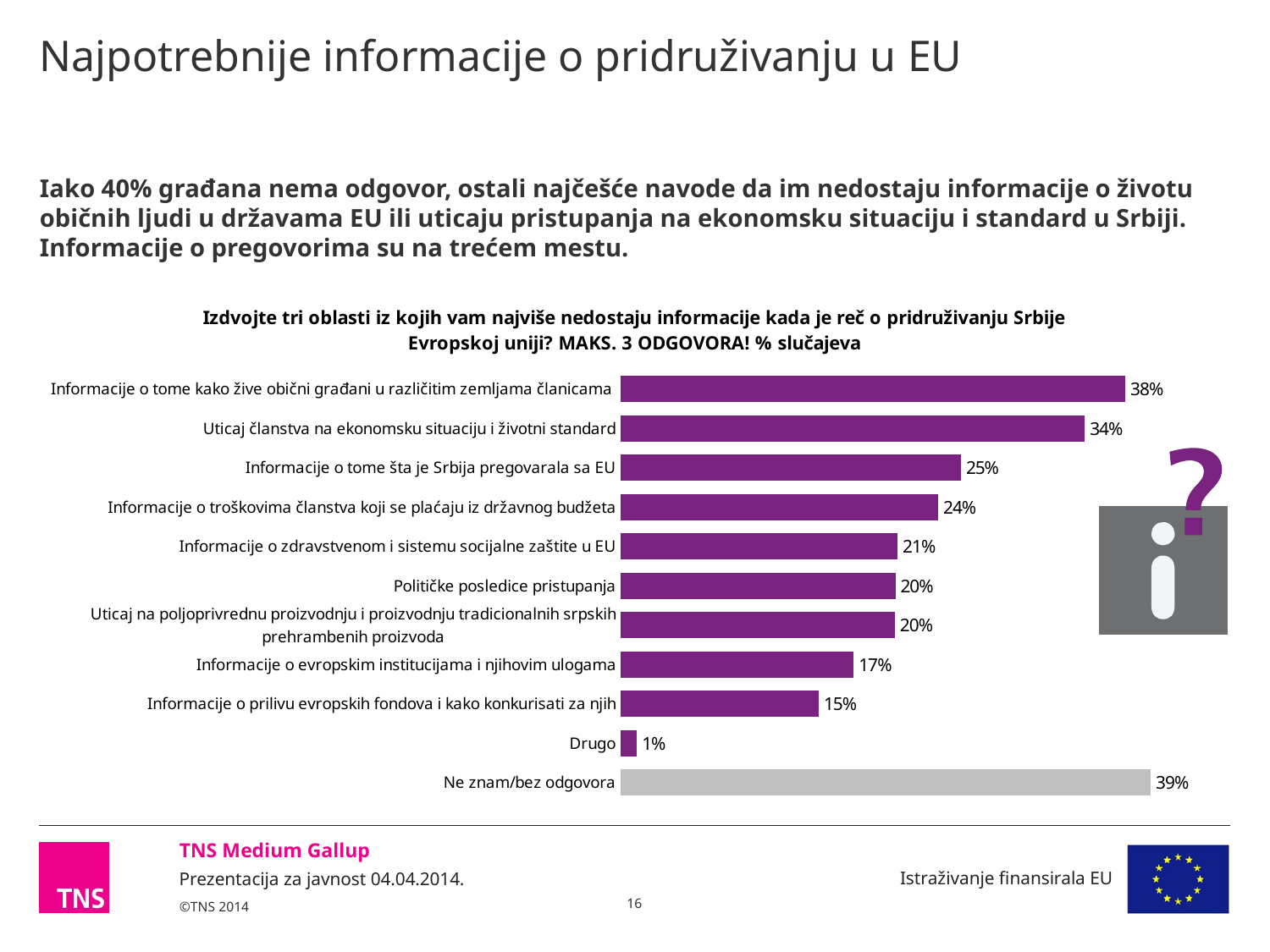
What is the value for "Informacije o prilivu evropskih fondova i kako konkurisati za njih"? 15% What is the value for "Informacije o tome kako žive obični građani u različitim zemljama članicama"? 38% How many categories are shown in the chart? 11 Which category has the lowest value? Drugo What type of chart is shown on the slide? Bar chart Which category has the highest value? Ne znam/bez odgovora Which category's bar is shown in grey rather than purple? Ne znam/bez odgovora What is the value for "Ne znam/bez odgovora"? 39% What is the value for "Informacije o tome šta je Srbija pregovarala sa EU"? 25% What is the difference between the values for "Informacije o tome kako žive obični građani u različitim zemljama članicama" and "Uticaj članstva na ekonomsku situaciju i životni standard"? 4% What is the value for "Uticaj članstva na ekonomsku situaciju i životni standard"? 34% Which is larger: the value for "Informacije o troškovima članstva koji se plaćaju iz državnog budžeta" or for "Informacije o zdravstvenom i sistemu socijalne zaštite u EU"? Informacije o troškovima članstva koji se plaćaju iz državnog budžeta